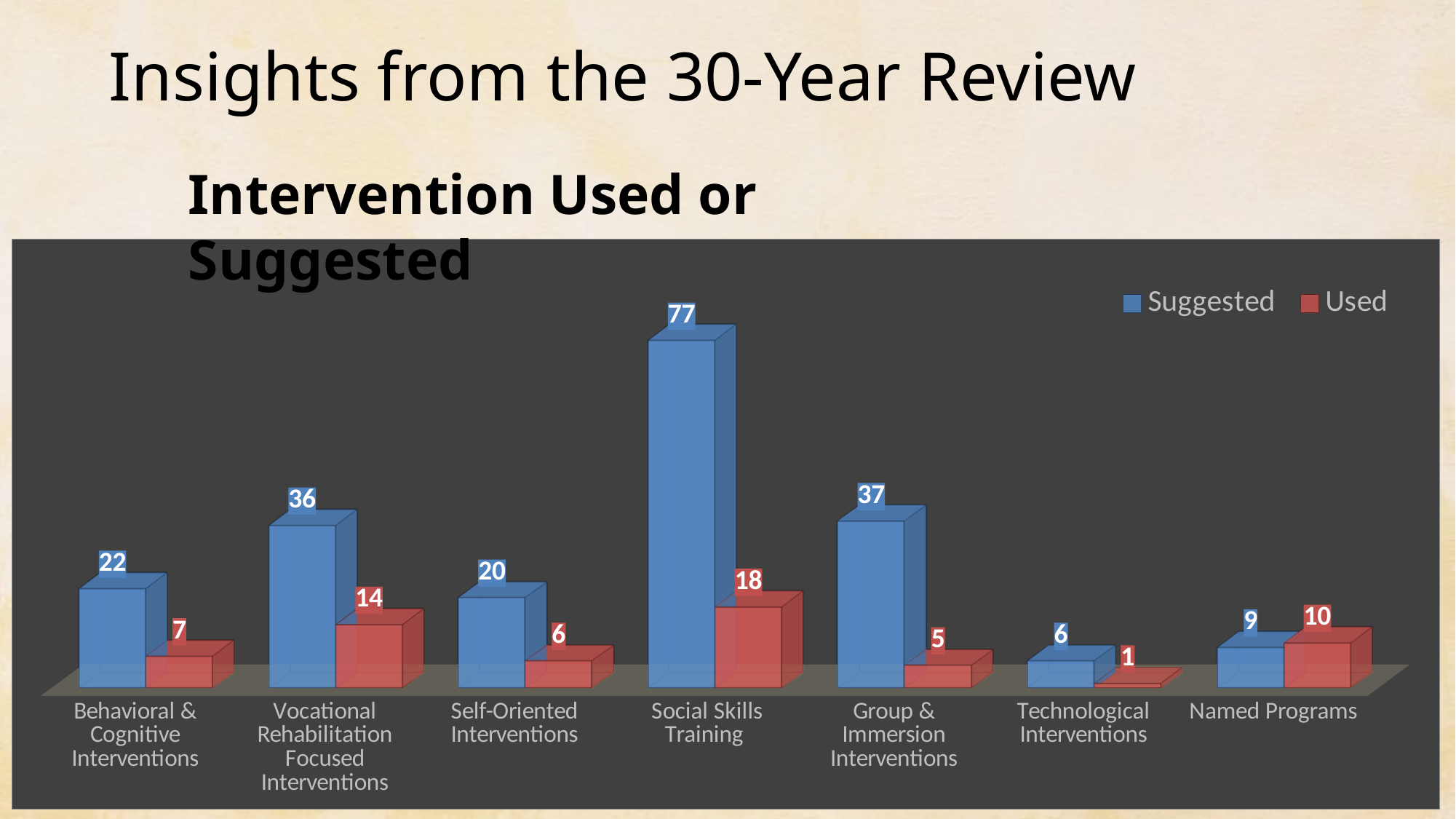
What is the difference between the Suggested and Used values for Social Skills Training? 59 What is the title of the chart? Intervention Used or Suggested Which category has the lowest Used value? Technological Interventions What is the Used value for Technological Interventions? 1 What is the Used value for Vocational Rehabilitation Focused Interventions? 14 Which category has the highest Suggested value? Social Skills Training Which is larger, the Suggested value for Vocational Rehabilitation Focused Interventions or the Suggested value for Group & Immersion Interventions? Group & Immersion Interventions Which is larger for Named Programs, the Suggested value or the Used value? Used How many categories are shown on the x axis? 7 What is the Suggested value for Social Skills Training? 77 What kind of chart is shown? Bar chart How many series does the legend list? 2